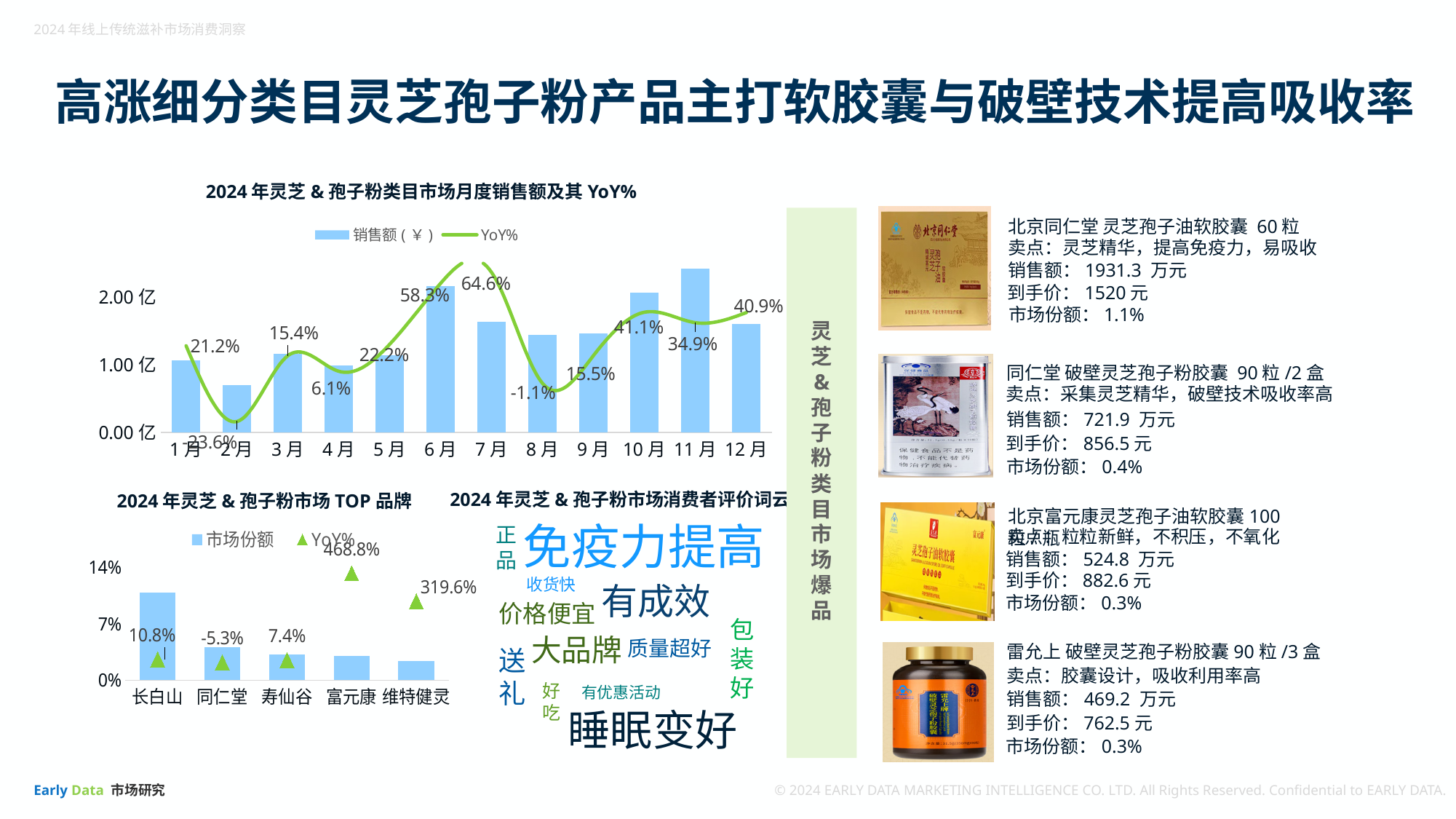
In the chart '2024 年灵芝 & 孢子粉类目市场月度销售额及其 YoY%', which month has the highest YoY%? 7 月 In the chart '2024 年灵芝 & 孢子粉类目市场月度销售额及其 YoY%', how many series does the legend list? 2 In the chart '2024 年灵芝 & 孢子粉类目市场月度销售额及其 YoY%', what is the YoY% value for 7 月? 64.6% In the chart '2024 年灵芝 & 孢子粉类目市场月度销售额及其 YoY%', what is the difference between the YoY% of 12 月 and 11 月? 6.0% In the chart '2024 年灵芝 & 孢子粉市场 TOP 品牌', is the 市场份额 for 长白山 greater or less than 7%? greater In the chart '2024 年灵芝 & 孢子粉市场 TOP 品牌', how many brands are shown on the x axis? 5 In the chart '2024 年灵芝 & 孢子粉市场 TOP 品牌', which brand has the lowest YoY%? 同仁堂 In the chart '2024 年灵芝 & 孢子粉类目市场月度销售额及其 YoY%', is the 销售额 for 7 月 greater or less than 1.00 亿? greater In the chart '2024 年灵芝 & 孢子粉类目市场月度销售额及其 YoY%', which month has the lowest YoY%? 2 月 In the chart '2024 年灵芝 & 孢子粉类目市场月度销售额及其 YoY%', which month has the highest 销售额 bar? 11 月 In the chart '2024 年灵芝 & 孢子粉市场 TOP 品牌', what is the YoY% value for 富元康? 468.8% In the chart '2024 年灵芝 & 孢子粉类目市场月度销售额及其 YoY%', what is the YoY% value for 2 月? -23.6%